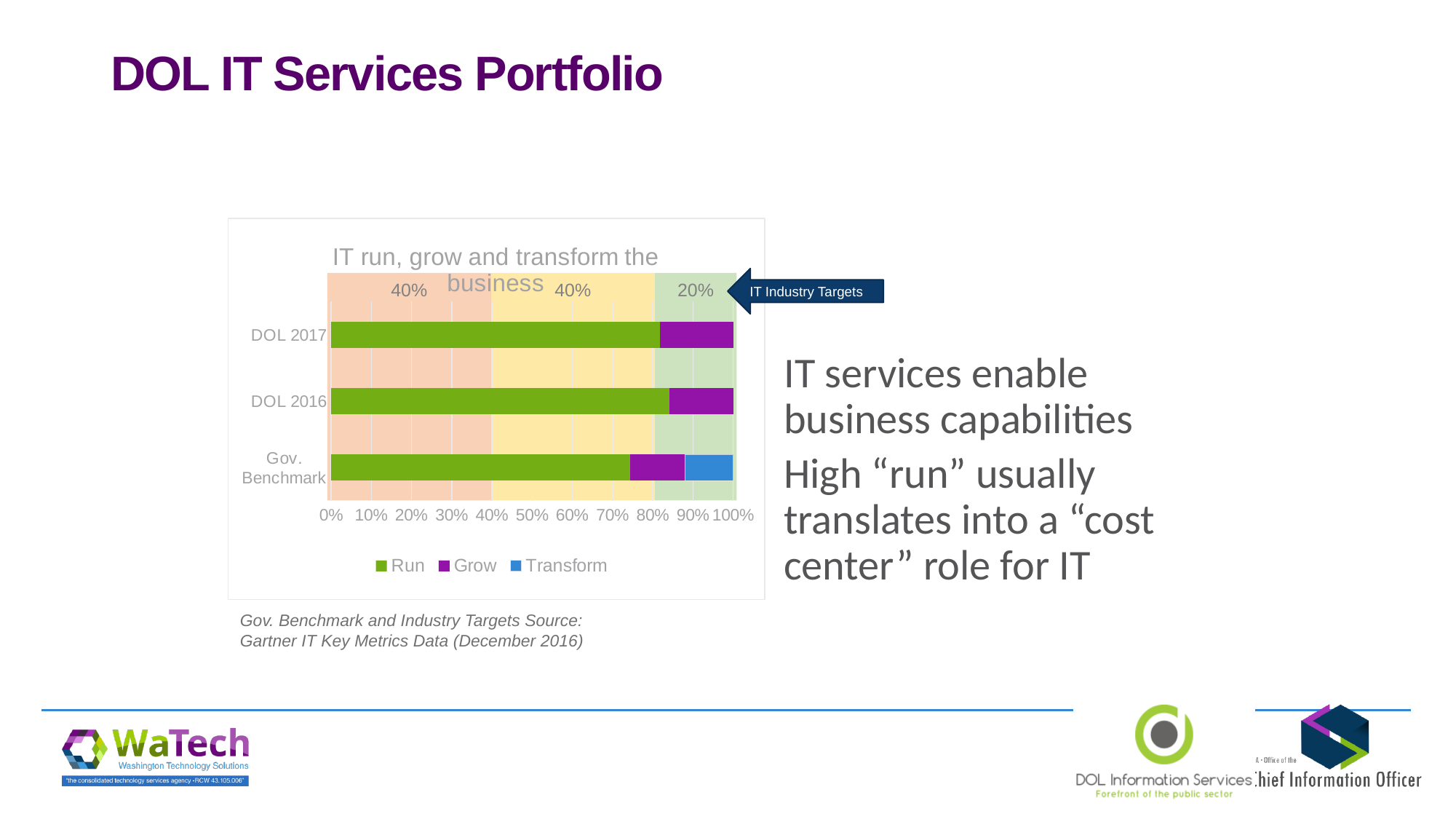
How many categories are plotted on the y axis of the chart? 3 What is the title of the chart? IT run, grow and transform the business What kind of chart is shown on the slide? Stacked bar chart How many series does the chart's legend list? 3 Is the Run value for Gov. Benchmark greater or less than 80%? less Which is larger, the Run value for DOL 2016 or for Gov. Benchmark? DOL 2016 What are the series names listed in the chart's legend? Run, Grow, Transform According to the IT Industry Targets shown on the chart, what is the target share for Transform? 20% Which category has the lowest Run value? Gov. Benchmark Is the Run value for DOL 2017 greater or less than 70%? greater Is the Run value for DOL 2016 greater or less than 60%? greater Which category is the only one with a visible Transform segment? Gov. Benchmark